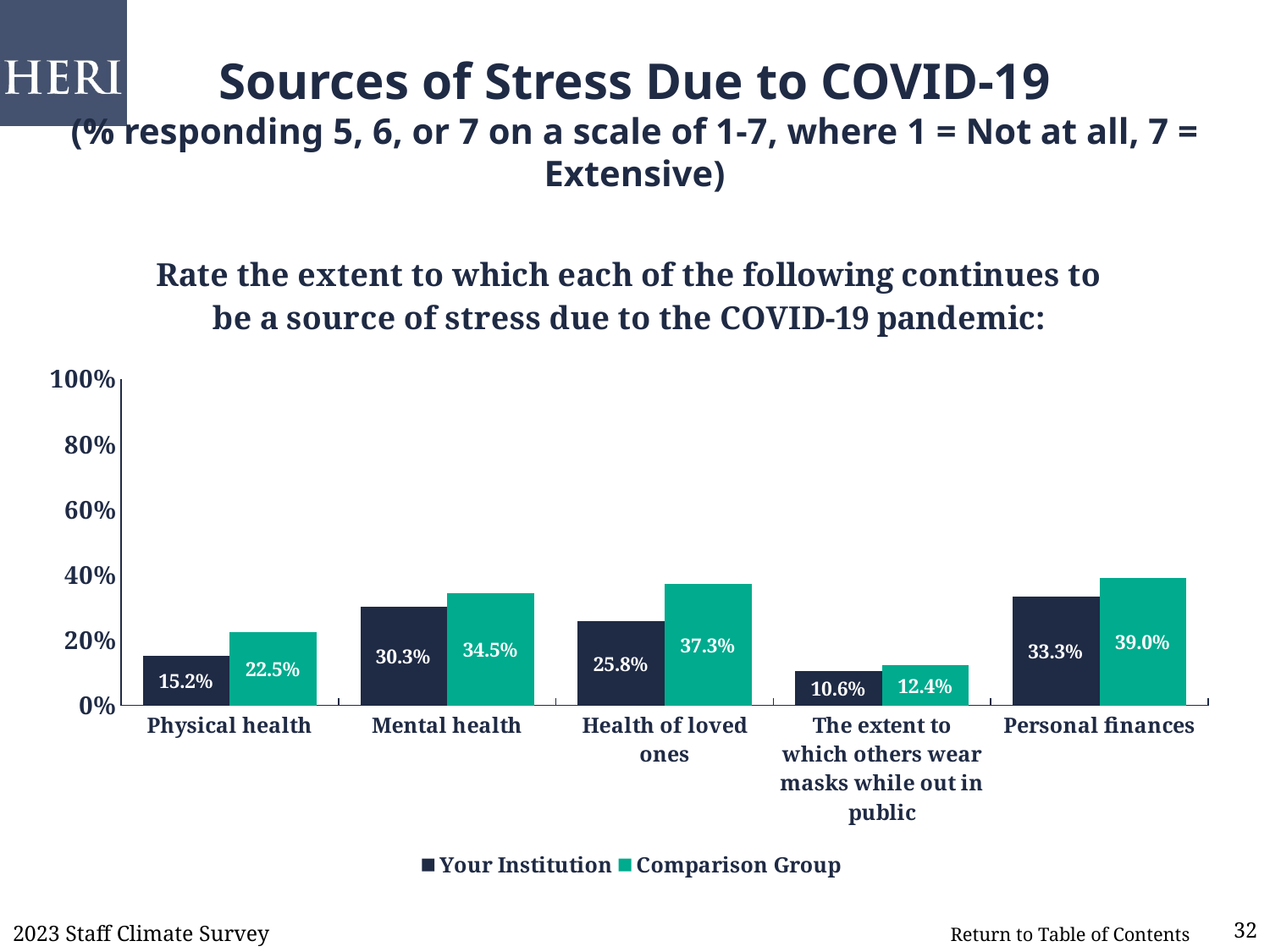
How many categories are shown on the x axis? 5 Which category has the highest value for Comparison Group? Personal finances What is the value for Comparison Group for Health of loved ones? 37.3% Which is larger for Personal finances: Your Institution or Comparison Group? Comparison Group How many series does the legend list? 2 What are the two series named in the legend? Your Institution and Comparison Group What is the value for Your Institution for The extent to which others wear masks while out in public? 10.6% What is the difference between the Comparison Group and Your Institution values for Physical health? 7.3% What is the value for Your Institution for Mental health? 30.3% Which category has the lowest value for Your Institution? The extent to which others wear masks while out in public Is the Comparison Group value for Mental health greater or less than 40%? less What kind of chart is shown on the slide? bar chart